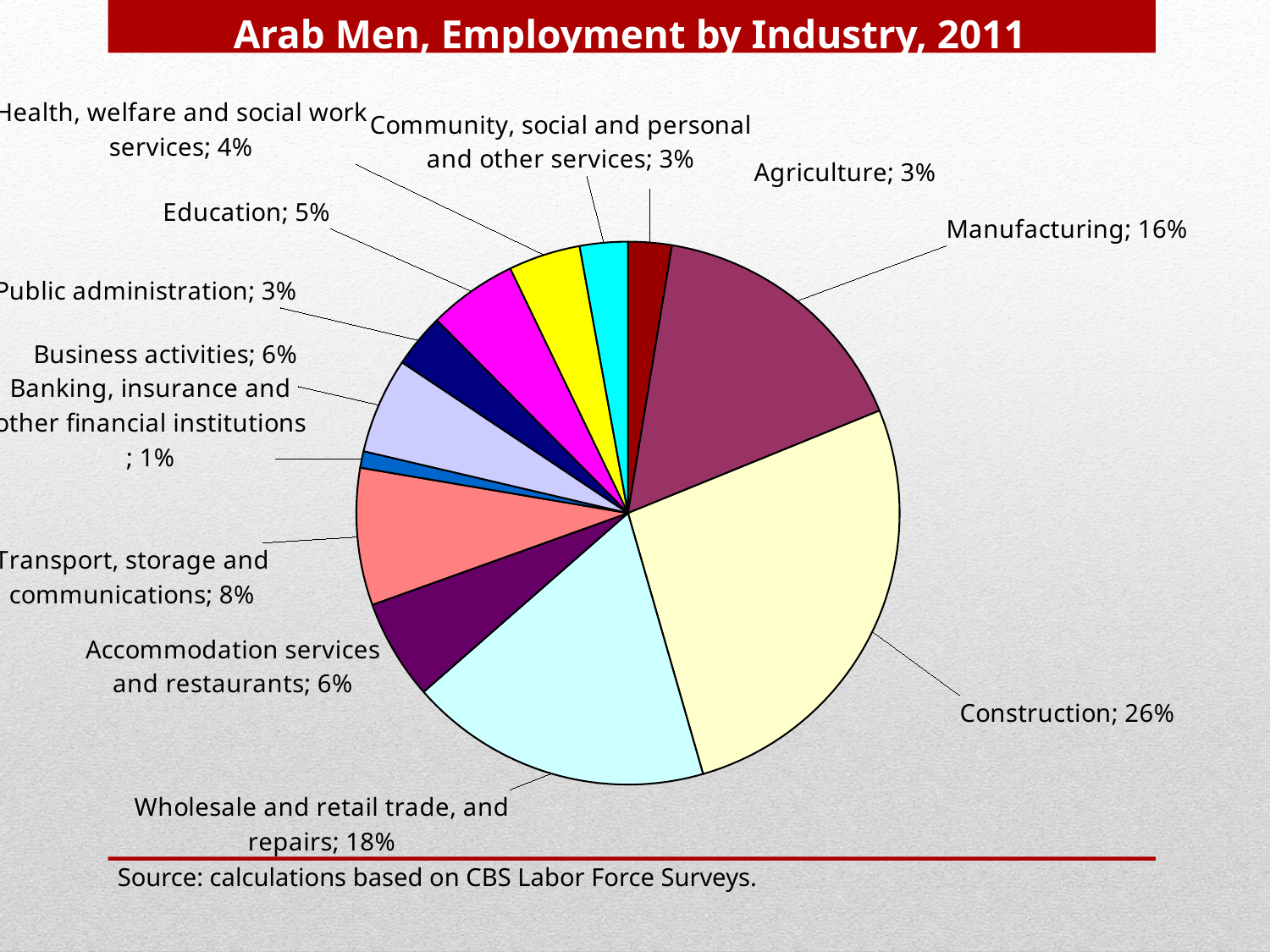
What share of employment is in Wholesale and retail trade, and repairs? 18% What share of employment is in Transport, storage and communications? 8% What kind of chart is shown on the slide? Pie chart Which has a larger share, Education or Business activities? Business activities What share of employment is in Construction? 26% Which industry has the largest share of employment? Construction Which industry has the smallest share of employment? Banking, insurance and other financial institutions What is the difference between the Construction share and the Manufacturing share? 10% What is the combined share of Construction and Wholesale and retail trade, and repairs? 44% What share of employment is in Manufacturing? 16% How many industry slices does the pie chart have? 12 What is the title of the chart? Arab Men, Employment by Industry, 2011